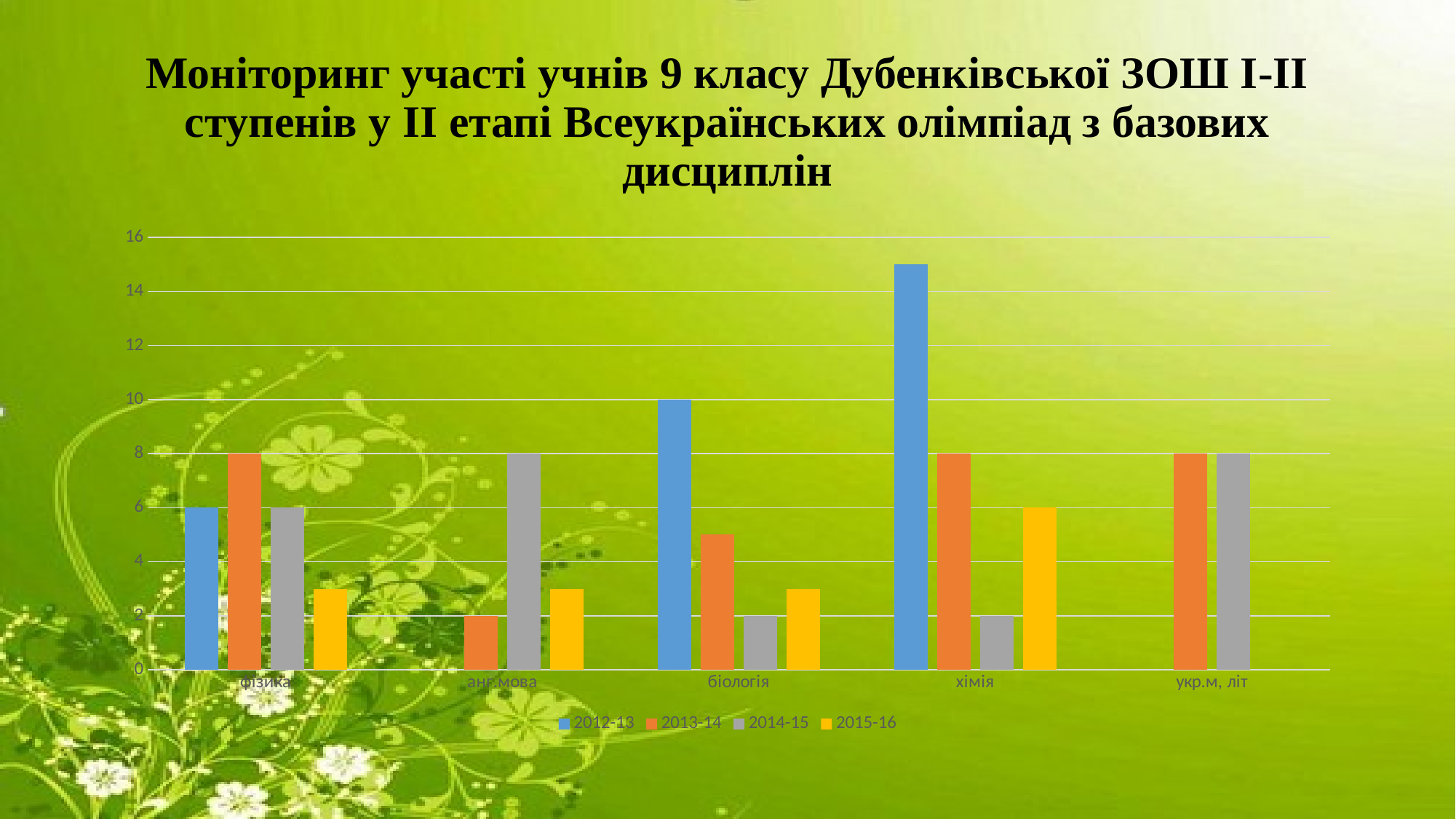
Which category has the lowest value for the 2013-14 series? анг.мова What is the value for 2013-14 in the фізика category? 8 How many categories are shown on the x axis? 5 Which category has the highest value for the 2012-13 series? хімія What is the value for 2015-16 in the хімія category? 6 How many series does the legend list? 4 What is the value for 2012-13 in the біологія category? 10 What kind of chart is shown on the slide? bar chart In the хімія category, what is the difference between the 2015-16 value and the 2014-15 value? 4 What is the value for 2014-15 in the анг.мова category? 8 Is the value for 2012-13 in the хімія category greater or less than 14? greater In the біологія category, which series has the larger value, 2012-13 or 2013-14? 2012-13